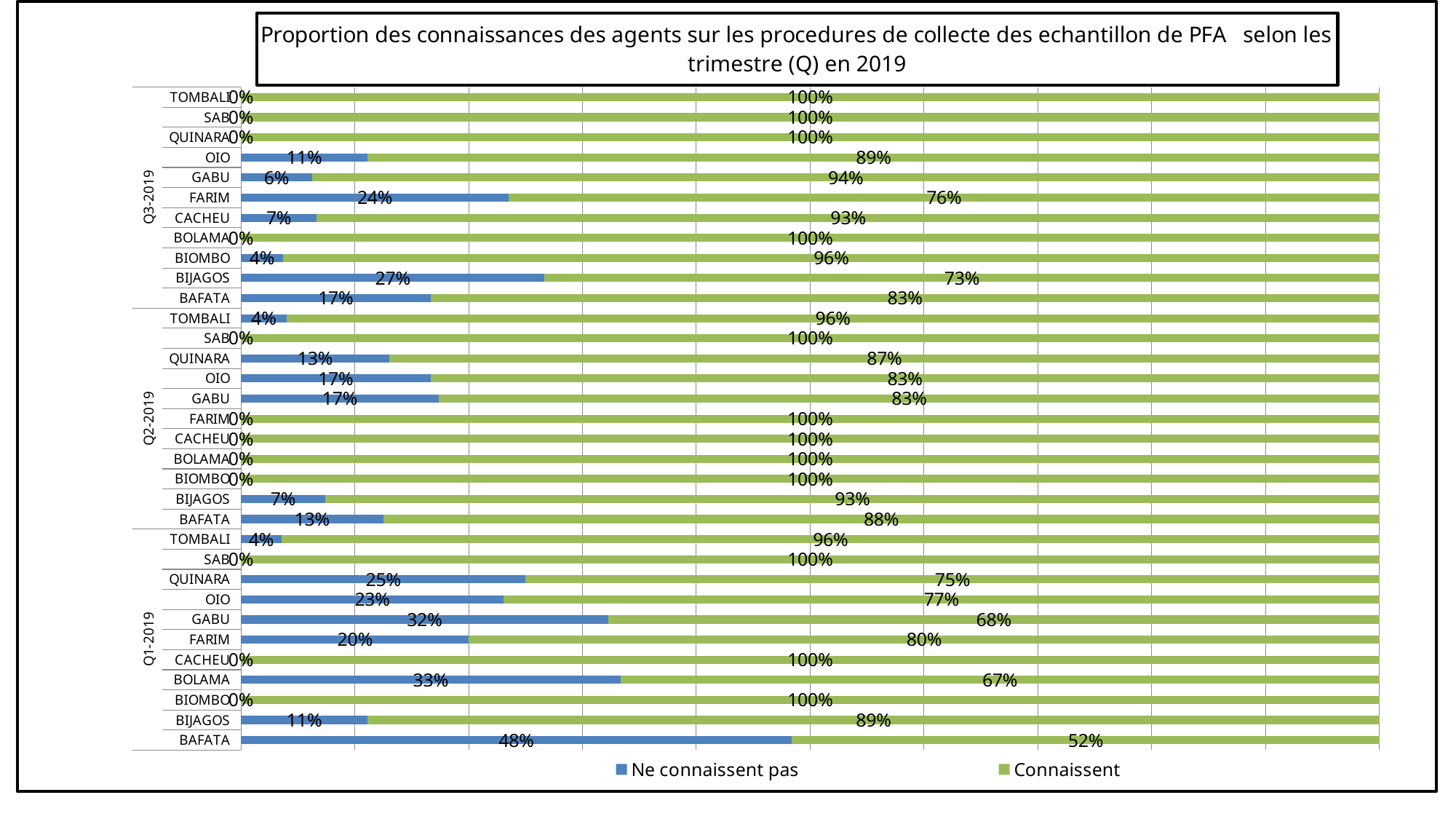
What are the two legend entries of the chart? Ne connaissent pas; Connaissent What is the value of "Connaissent" for BIJAGOS in Q3-2019? 73% For GABU in Q1-2019, what is the difference between the "Connaissent" and "Ne connaissent pas" values? 36% What is the value of "Ne connaissent pas" for BAFATA in Q1-2019? 48% How many series does the legend list? 2 What kind of chart is shown on the slide? Bar chart Within Q1-2019, which region has the highest "Ne connaissent pas" value? BAFATA What is the value of "Connaissent" for BAFATA in Q2-2019? 88% How many quarters (Q groups) are shown on the chart? 3 Within Q3-2019, which region has the lowest "Connaissent" value? BIJAGOS In Q3-2019, which has the larger "Ne connaissent pas" value: FARIM or BAFATA? FARIM What is the value of "Ne connaissent pas" for QUINARA in Q2-2019? 13%